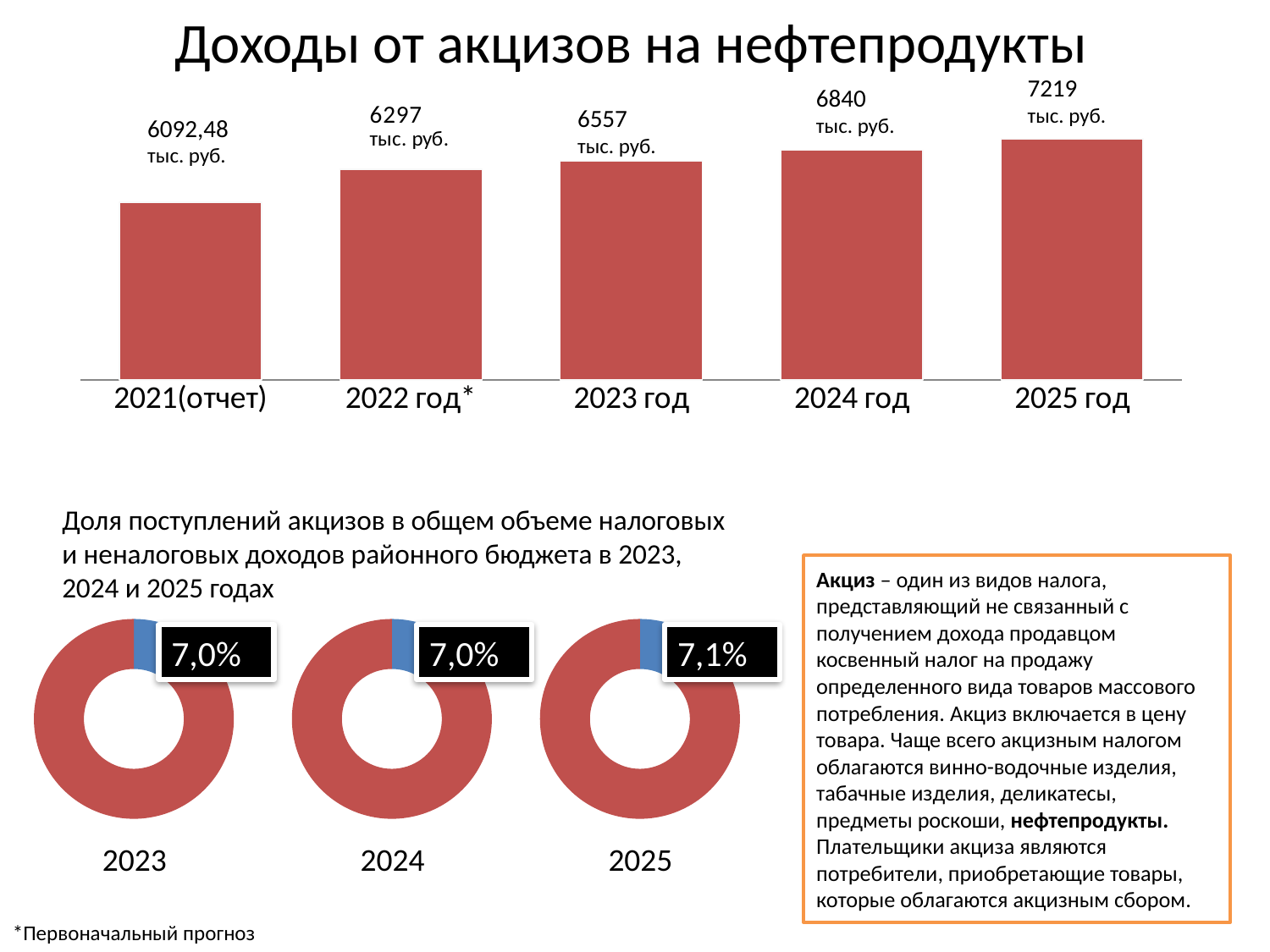
In the bar chart 'Доходы от акцизов на нефтепродукты', what is the difference between the values for 2023 год and 2022 год*? 260 тыс. руб. What kind of chart is the top chart 'Доходы от акцизов на нефтепродукты'? Bar chart In the bar chart 'Доходы от акцизов на нефтепродукты', do the values rise or fall from 2021 to 2025? Rise In the bar chart 'Доходы от акцизов на нефтепродукты', which year has the highest value? 2025 год In the bar chart 'Доходы от акцизов на нефтепродукты', what is the value for 2022 год*? 6297 тыс. руб. In the bar chart 'Доходы от акцизов на нефтепродукты', what is the difference between the values for 2025 год and 2024 год? 379 тыс. руб. In the bar chart 'Доходы от акцизов на нефтепродукты', which category has the lowest value? 2021(отчет) How many bars are in the bar chart 'Доходы от акцизов на нефтепродукты'? 5 In the donut chart for 2025 at the bottom of the slide, what share is shown for the excise revenue? 7,1% In the bar chart 'Доходы от акцизов на нефтепродукты', what is the value for 2024 год? 6840 тыс. руб. In the bar chart 'Доходы от акцизов на нефтепродукты', what is the value for 2021(отчет)? 6092,48 тыс. руб. In the bar chart 'Доходы от акцизов на нефтепродукты', which is larger: the value for 2023 год or 2024 год? 2024 год